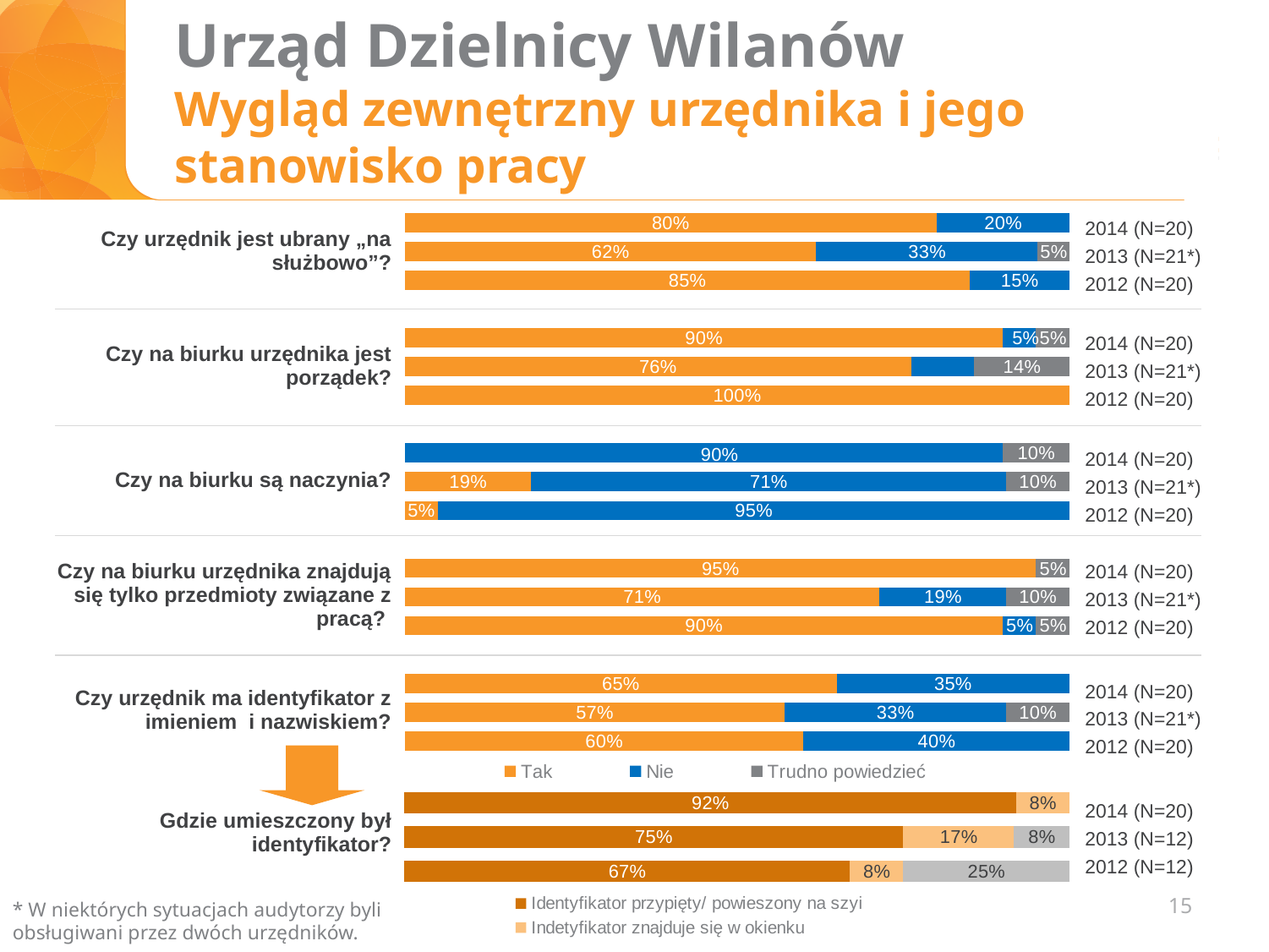
In the chart for "Czy na biurku są naczynia?", what is the difference between the "Nie" percentages for 2014 (N=20) and 2013 (N=21*)? 19 percentage points In the chart for "Czy urzędnik jest ubrany „na służbowo”?", what percentage answered "Nie" in 2013 (N=21*)? 33% In the chart for "Czy urzędnik jest ubrany „na służbowo”?", what percentage answered "Tak" in 2014 (N=20)? 80% In the chart for "Czy na biurku są naczynia?", what percentage answered "Nie" in 2012 (N=20)? 95% In the chart for "Gdzie umieszczony był identyfikator?", what is the difference between the "Identyfikator przypięty/ powieszony na szyi" percentages for 2013 (N=12) and 2012 (N=12)? 8 percentage points In the chart for "Czy na biurku urzędnika jest porządek?", what percentage answered "Tak" in 2012 (N=20)? 100% In the chart for "Gdzie umieszczony był identyfikator?", what percentage had the identifier pinned/hung around the neck in 2014 (N=20)? 92% In the chart for "Czy na biurku urzędnika znajdują się tylko przedmioty związane z pracą?", which year has the highest "Tak" percentage? 2014 (N=20) In the chart for "Czy na biurku urzędnika jest porządek?", which year has the lowest "Tak" percentage? 2013 (N=21*) What type of chart is used on this slide? Stacked bar chart In the chart for "Czy urzędnik ma identyfikator z imieniem i nazwiskiem?", is the "Tak" percentage larger in 2014 (N=20) or in 2012 (N=20)? 2014 (N=20) In the chart for "Czy urzędnik ma identyfikator z imieniem i nazwiskiem?", what percentage answered "Trudno powiedzieć" in 2013 (N=21*)? 10%